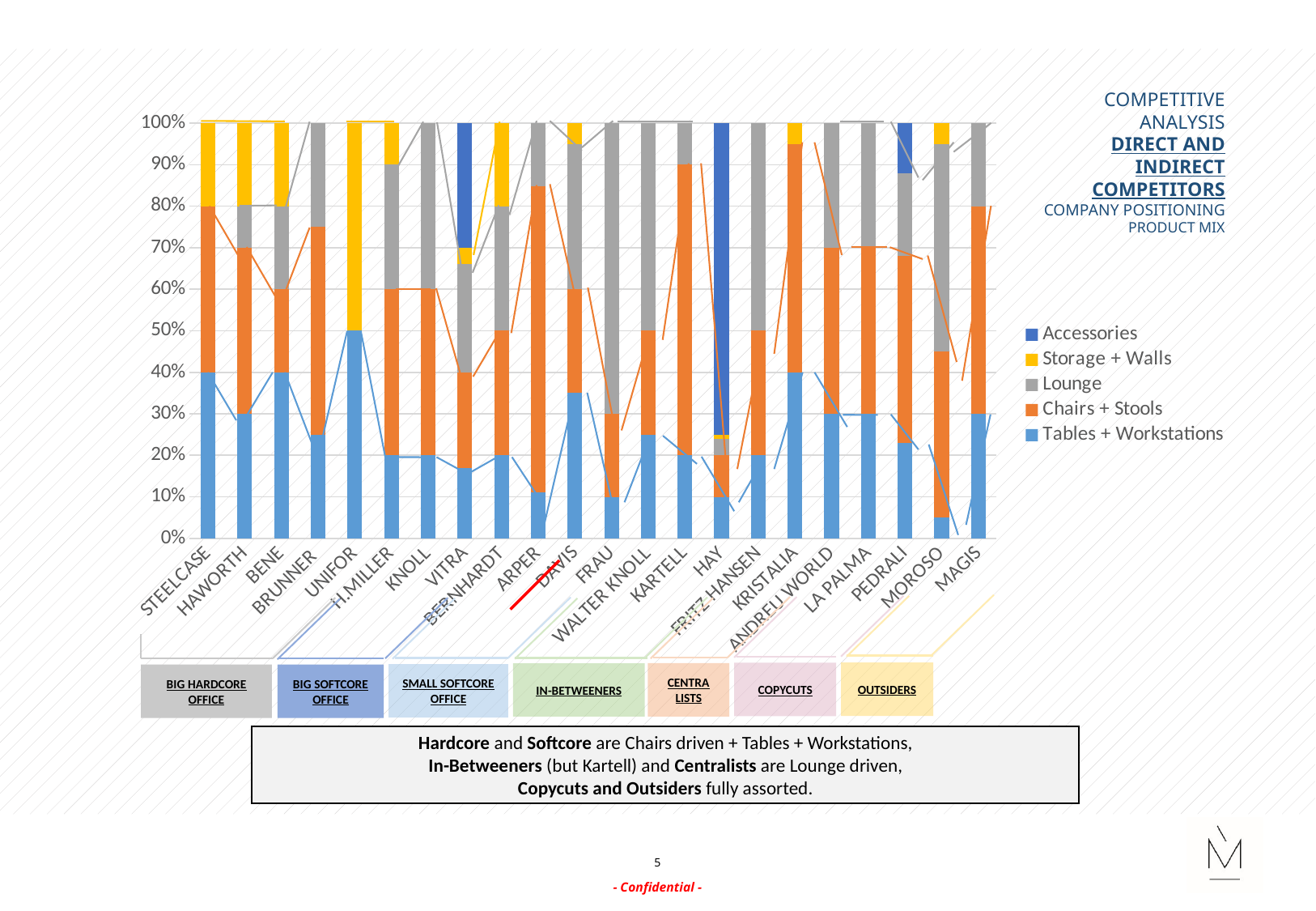
Which company has the larger Tables + Workstations share, UNIFOR or KNOLL? UNIFOR Is the Tables + Workstations share for MOROSO greater or less than 10%? less Which company has the larger Tables + Workstations share, STEELCASE or HAWORTH? STEELCASE Is the Accessories share for HAY greater or less than 50%? greater How many companies are shown along the x axis of the chart? 22 What is the Tables + Workstations share for UNIFOR? 50% Is the Tables + Workstations share for KRISTALIA greater or less than 30%? greater How many series does the chart legend list? 5 What is the Tables + Workstations share for STEELCASE? 40% Which series is listed first (at the top) in the chart legend? Accessories What kind of chart is shown on the slide? Stacked bar chart What colour represents Storage + Walls in the chart? Yellow